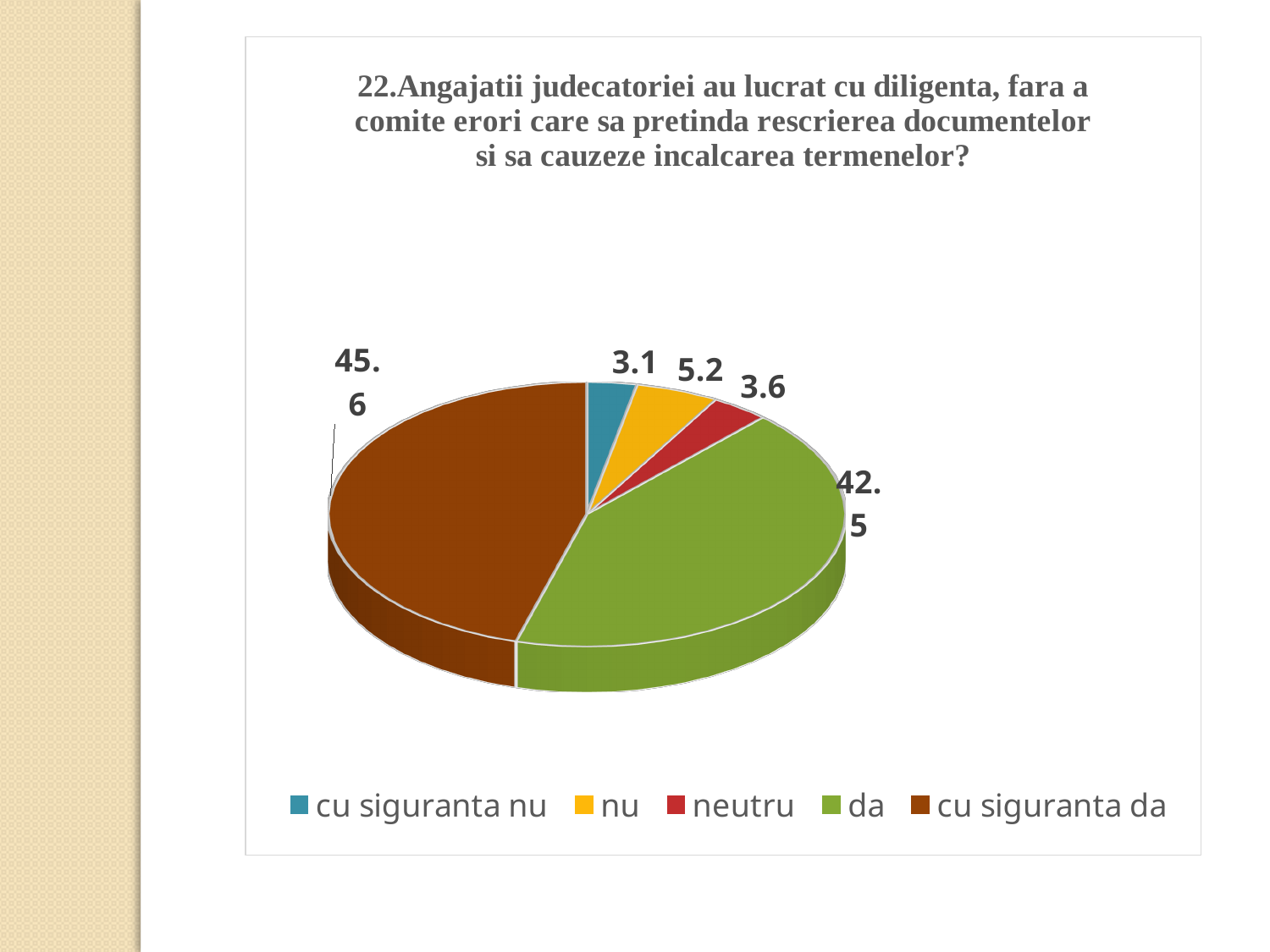
How many categories does the pie chart have? 5 Which category has the largest slice? cu siguranta da What is the value for "da"? 42.5 Which is larger, the value for "nu" or the value for "neutru"? nu What is the value for "cu siguranta nu"? 3.1 What is the value for "nu"? 5.2 What is the value for "cu siguranta da"? 45.6 Which colour represents "neutru" in the legend? red What is the value for "neutru"? 3.6 Which category has the smallest slice? cu siguranta nu What is the difference between the values for "cu siguranta da" and "da"? 3.1 What kind of chart is shown on the slide? pie chart